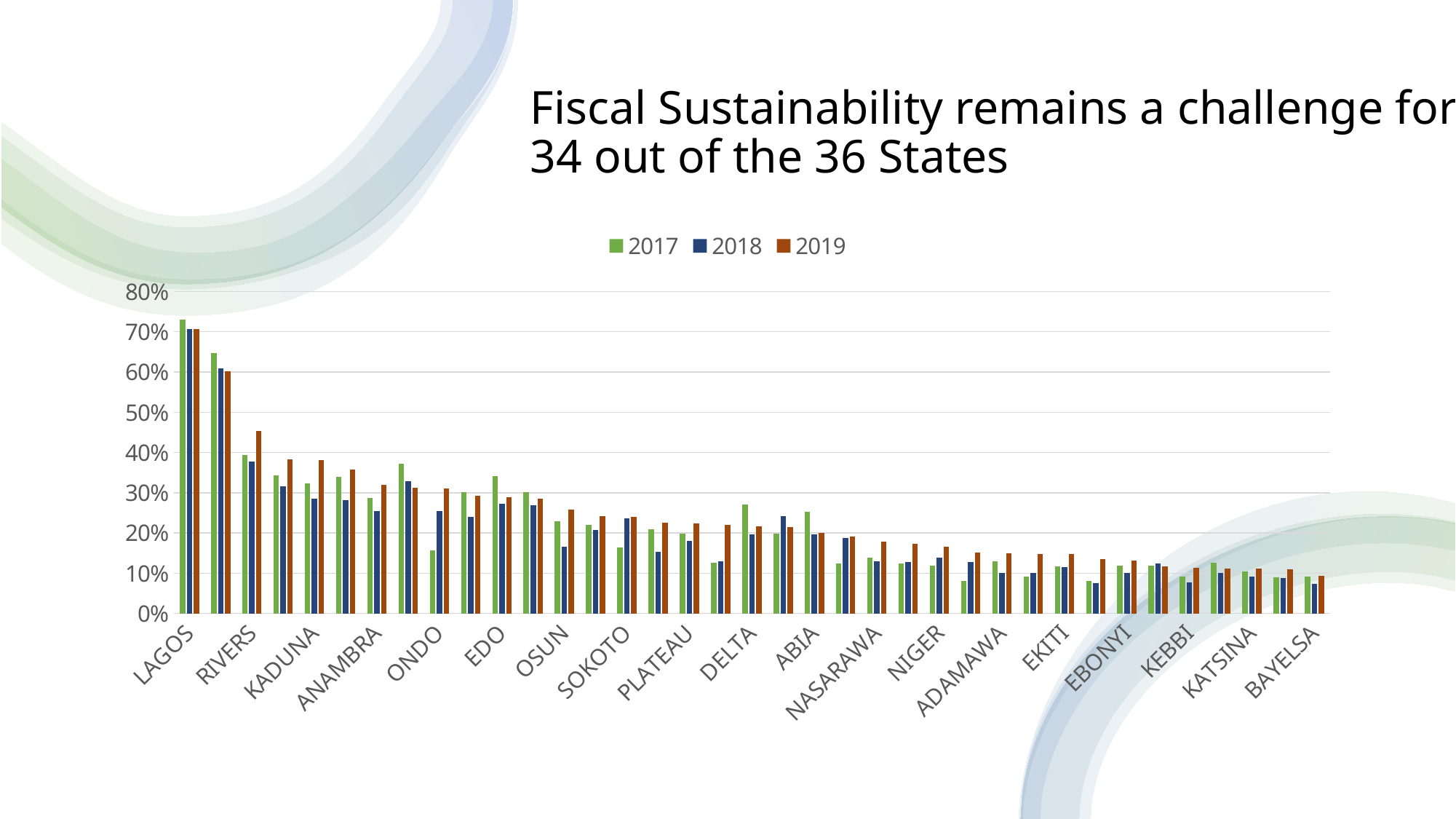
For DELTA, which year has the highest value? 2017 How many series does the legend list? 3 Do the 2017 values generally rise or fall moving from LAGOS on the left to BAYELSA on the right? fall Is the 2017 value for LAGOS greater or less than 70%? greater Which is larger, the 2019 value for RIVERS or the 2019 value for KADUNA? RIVERS What are the series names listed in the legend? 2017, 2018, 2019 Is the 2019 value for RIVERS greater or less than 70%? less Which state has the highest 2017 value? LAGOS Is the 2017 value for ONDO greater or less than 30%? less What kind of chart is shown on the slide? bar chart Which is larger, the 2017 value for LAGOS or the 2017 value for RIVERS? LAGOS